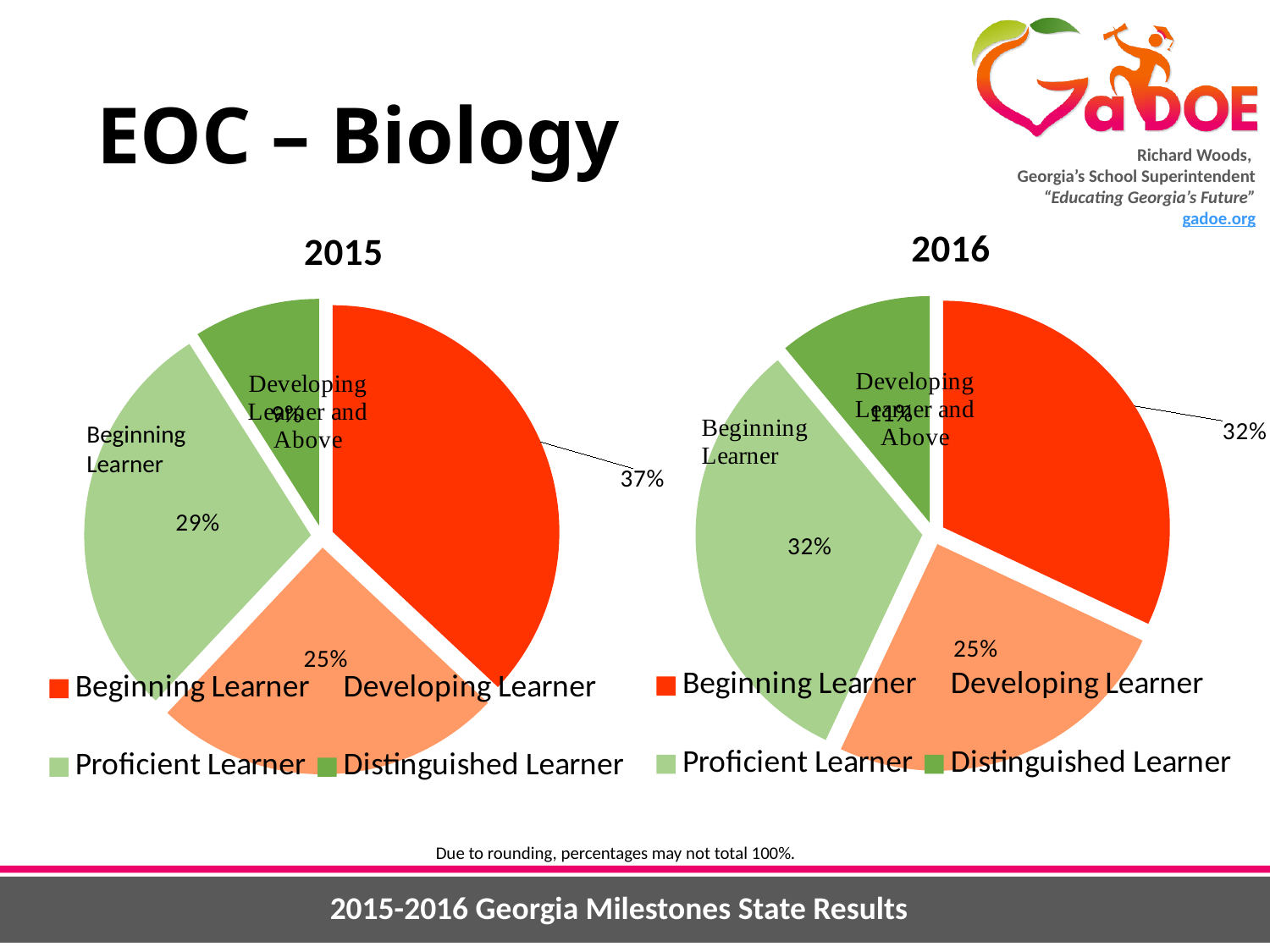
In the 2015 chart, what percentage is shown for Beginning Learner? 37% In the 2015 chart, what is the difference in percentage points between Beginning Learner and Developing Learner? 12 percentage points What colour represents Beginning Learner in the legend of the 2015 chart? Red In the 2015 chart, which category has the smallest slice? Distinguished Learner In the 2015 chart, what percentage is shown for Developing Learner? 25% In the 2016 chart, which is larger, Beginning Learner or Developing Learner? Beginning Learner In the 2015 chart, which category has the largest slice? Beginning Learner In the 2016 chart, which category has the smallest slice? Distinguished Learner How many categories does the legend of the 2016 chart list? 4 In the 2016 chart, what percentage is shown for Developing Learner? 25% What kind of chart is used for the 2015 data? Pie chart In the 2016 chart, what percentage is shown for Beginning Learner? 32%